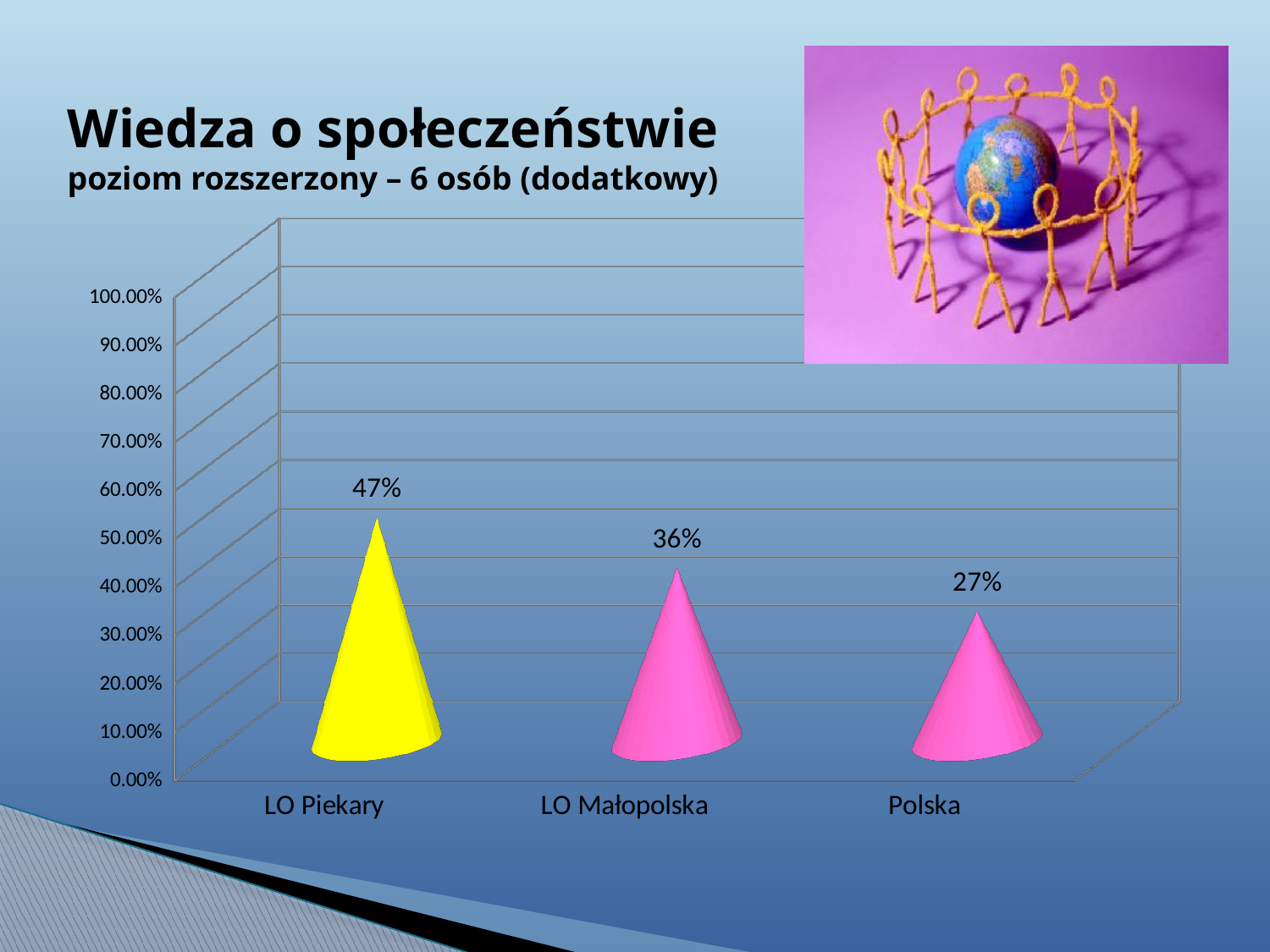
What is the difference between the values for LO Piekary and Polska? 20% What colour is the bar for LO Piekary? yellow What is the value for LO Piekary? 47% Do the values rise or fall from left to right along the x axis? fall What is the difference between the values for LO Piekary and LO Małopolska? 11% Which is larger, the value for LO Małopolska or the value for Polska? LO Małopolska What is the value for LO Małopolska? 36% Which category has the lowest value? Polska How many categories are shown on the x axis? 3 Which category has the highest value? LO Piekary What kind of chart is shown on the slide? bar chart What is the value for Polska? 27%